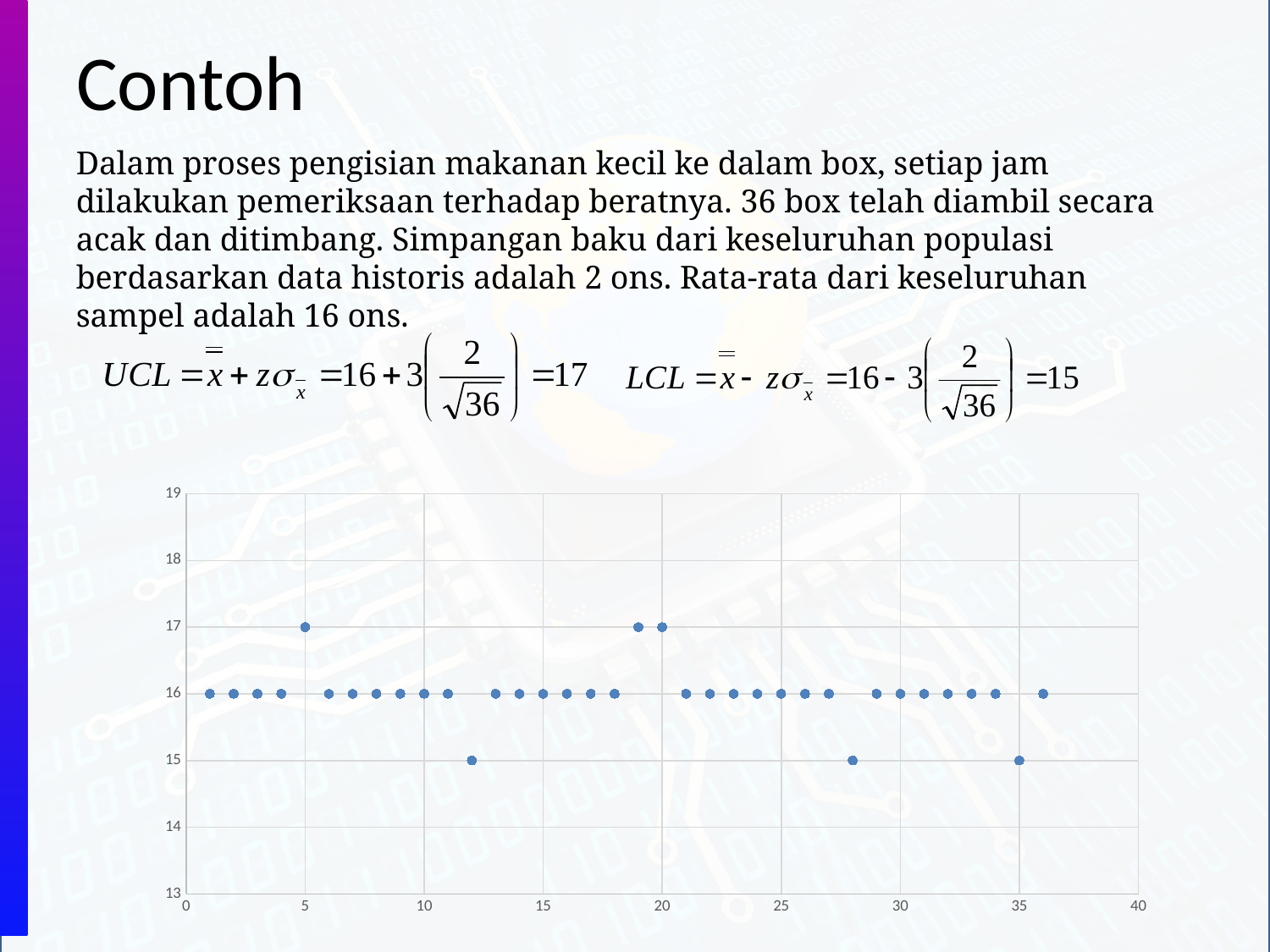
What is the maximum value shown on the y axis of the chart? 19 What is the y value of the point at x = 28? 15 What is the lowest y value reached by any point in the chart? 15 How many points in the chart have a y value of 15? 3 What is the y value of the point at x = 5? 17 What is the highest y value reached by any point in the chart? 17 What kind of chart is shown on the slide? scatter chart How many data points are plotted in the chart? 36 Which point has the larger y value, the one at x = 5 or the one at x = 12? x = 5 What is the y value of the point at x = 12? 15 What is the difference between the y value at x = 19 and the y value at x = 35? 2 How many points in the chart have a y value of 17? 3